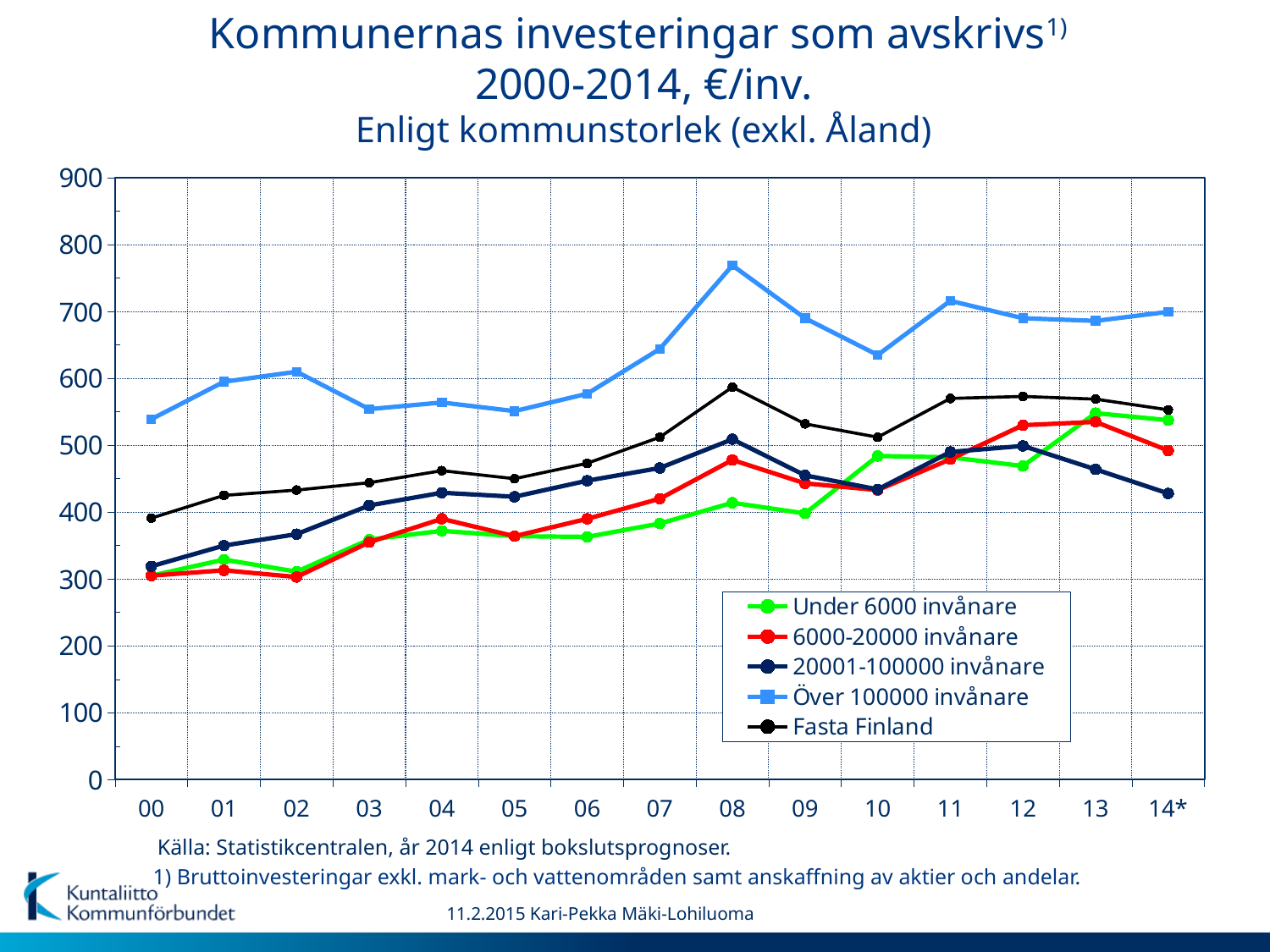
How many years are shown along the x axis? 15 How many series does the legend list? 5 Is the value for '6000-20000 invånare' in 12 greater or less than 500? greater Is the value for 'Fasta Finland' in 00 greater or less than 400? less In which year does the 'Över 100000 invånare' series reach its highest value? 08 In 14*, which is larger: 'Över 100000 invånare' or '20001-100000 invånare'? Över 100000 invånare Which series has the highest value in 00? Över 100000 invånare Is the value for 'Över 100000 invånare' in 08 greater or less than 700? greater What kind of chart is shown on the slide? line chart Which series has the lowest value in 14*? 20001-100000 invånare Does the 'Över 100000 invånare' series rise or fall from 00 to 02? rise What colour is the 'Fasta Finland' line? black